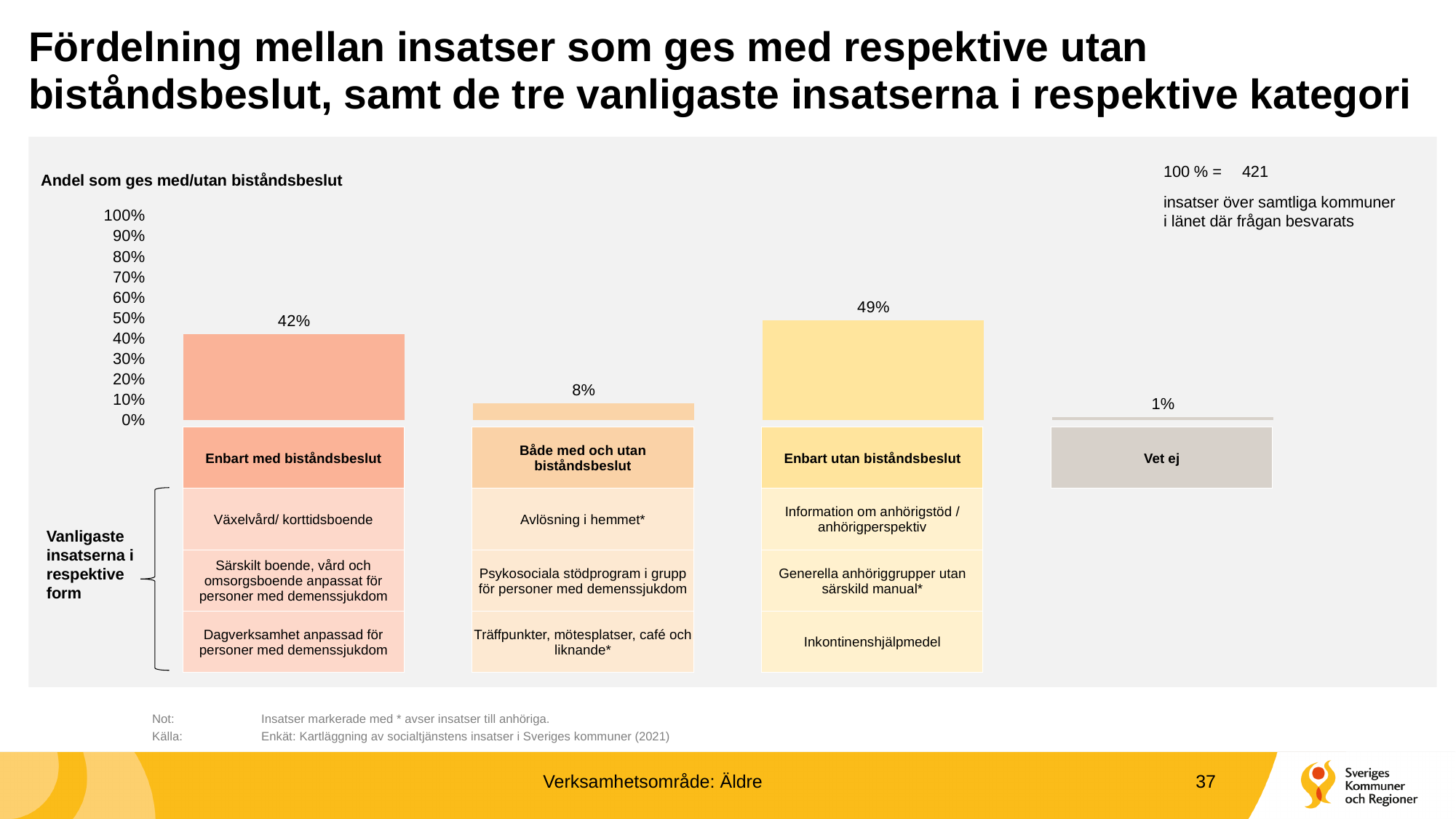
What is the value for "Enbart utan biståndsbeslut"? 49% What is the value for "Enbart med biståndsbeslut"? 42% What is the difference between the values for "Enbart utan biståndsbeslut" and "Enbart med biståndsbeslut"? 7% What is the value for "Vet ej"? 1% What is the title of the chart? Andel som ges med/utan biståndsbeslut How many categories are shown in the bar chart? 4 Which category has the lowest value? Vet ej Which category has the highest value? Enbart utan biståndsbeslut What is the value for "Både med och utan biståndsbeslut"? 8% Which is larger, the value for "Enbart med biståndsbeslut" or the value for "Både med och utan biståndsbeslut"? Enbart med biståndsbeslut What kind of chart is shown on the slide? bar chart Is the value for "Enbart med biståndsbeslut" greater or less than 50%? less